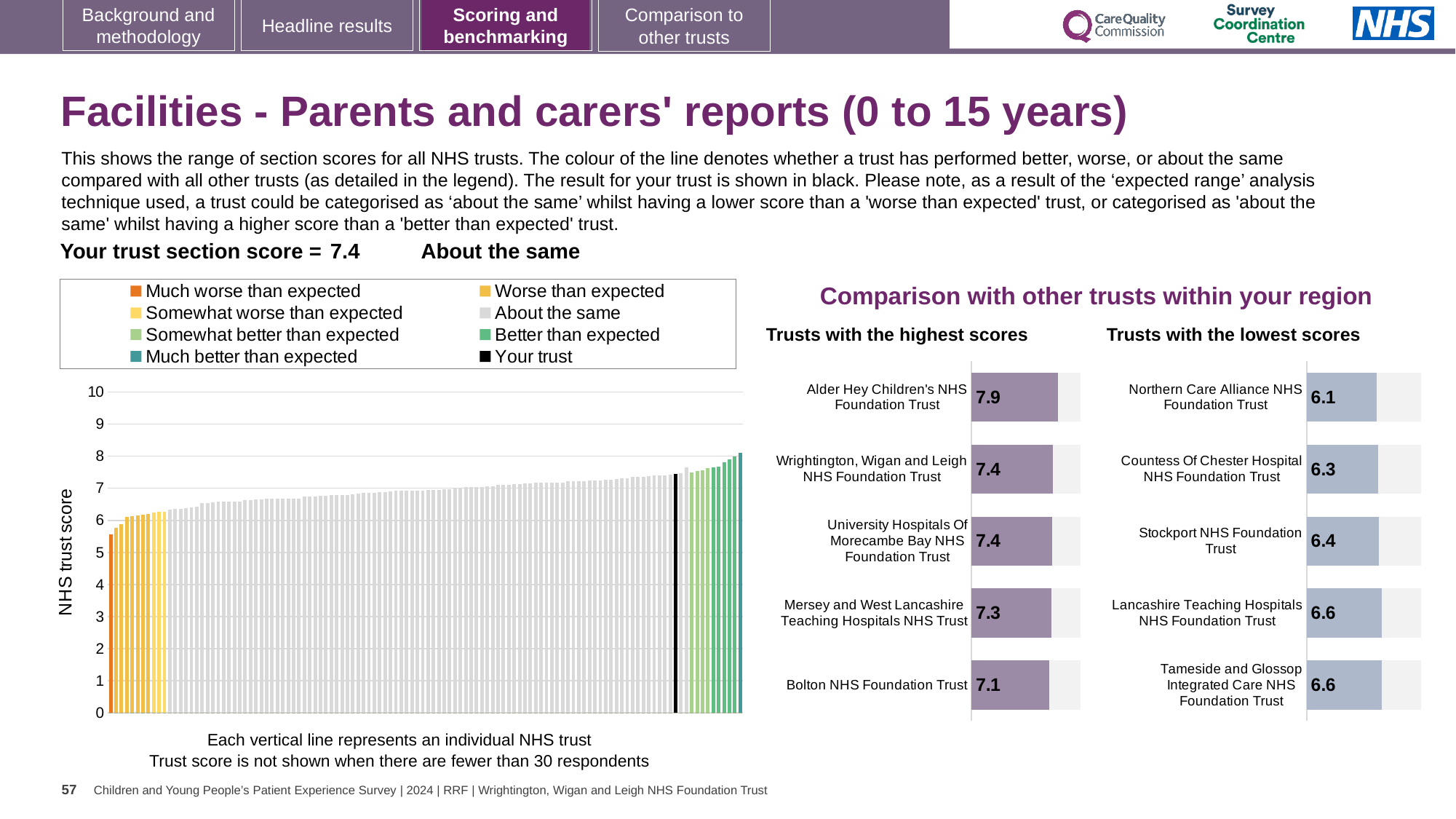
In the 'Trusts with the highest scores' chart, what is the score for Alder Hey Children's NHS Foundation Trust? 7.9 How many entries does the legend above the large chart on the left list? 8 In the large chart on the left, do the trust scores rise or fall from left to right? Rise In the 'Trusts with the highest scores' chart, what is the difference between the scores of Alder Hey Children's NHS Foundation Trust and Bolton NHS Foundation Trust? 0.8 In the 'Trusts with the lowest scores' chart, what is the score for Lancashire Teaching Hospitals NHS Foundation Trust? 6.6 What is the label on the vertical axis of the large chart on the left? NHS trust score How many trusts are shown in the 'Trusts with the highest scores' chart? 5 What kind of chart is the large chart on the left showing the range of section scores for all NHS trusts? Bar chart In the 'Trusts with the lowest scores' chart, which has the larger score: Countess Of Chester Hospital NHS Foundation Trust or Stockport NHS Foundation Trust? Stockport NHS Foundation Trust In the 'Trusts with the highest scores' chart, what is the score for Bolton NHS Foundation Trust? 7.1 In the 'Trusts with the highest scores' chart, which trust has the highest score? Alder Hey Children's NHS Foundation Trust In the 'Trusts with the lowest scores' chart, which trust has the lowest score? Northern Care Alliance NHS Foundation Trust